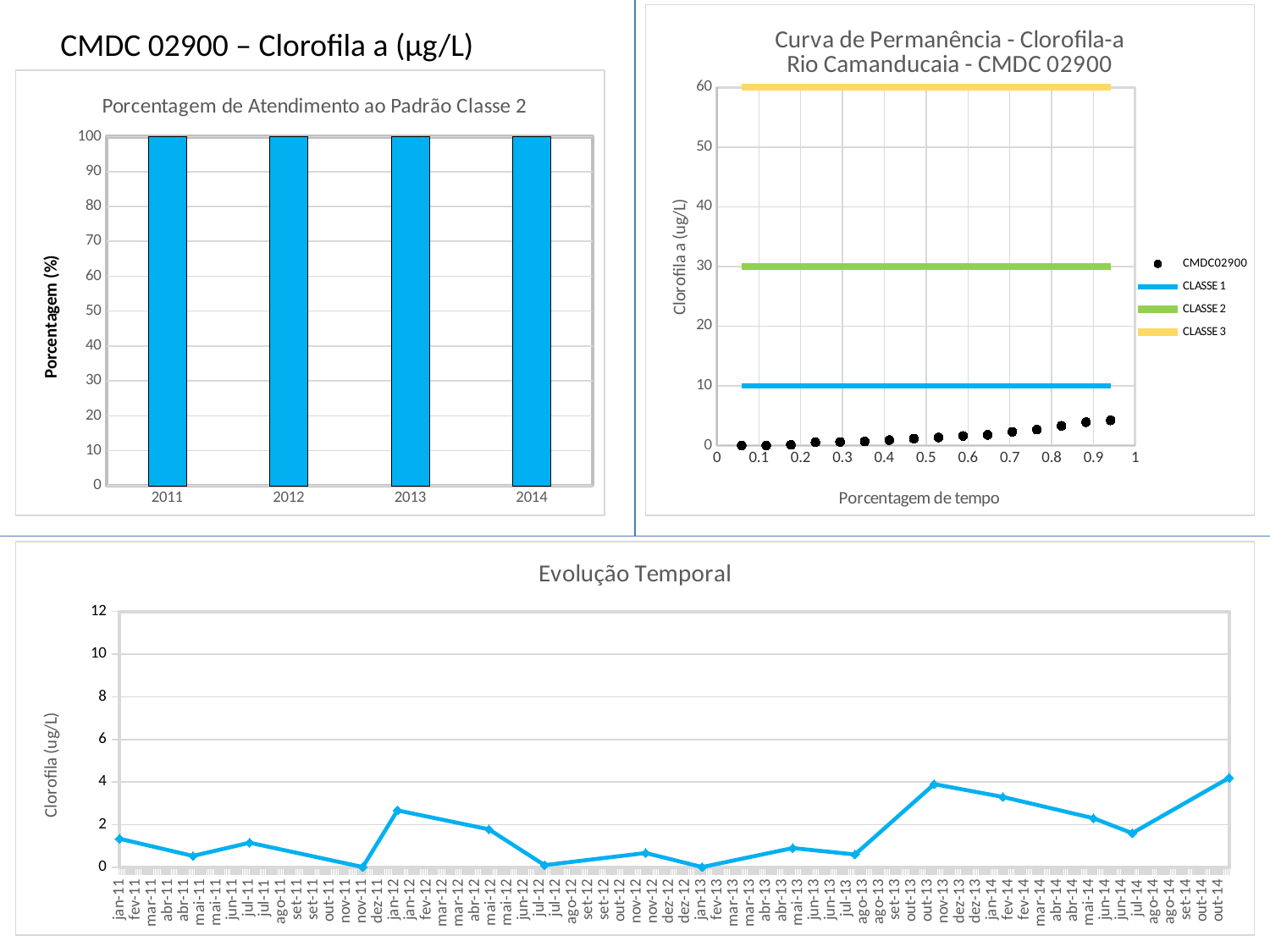
In the 'Evolução Temporal' chart, is the value for nov-11 greater or less than 2? less In the 'Evolução Temporal' chart, is the value for out-13 greater or less than 2? greater In the 'Curva de Permanência' chart, do the CMDC02900 points rise or fall as Porcentagem de tempo increases? rise In the 'Curva de Permanência' chart, at what Clorofila a value is the CLASSE 3 line drawn? 60 In the 'Porcentagem de Atendimento ao Padrão Classe 2' chart, what is the difference between the values for 2011 and 2014? 0 In the 'Porcentagem de Atendimento ao Padrão Classe 2' chart, what kind of chart is shown? bar chart In the 'Porcentagem de Atendimento ao Padrão Classe 2' chart, how many years are shown on the x axis? 4 In the 'Curva de Permanência' chart, at what Clorofila a value is the CLASSE 2 line drawn? 30 In the 'Curva de Permanência' chart, which class line is the lowest? CLASSE 1 In the 'Porcentagem de Atendimento ao Padrão Classe 2' chart, what is the label of the y axis? Porcentagem (%) In the 'Curva de Permanência' chart, how many entries does the legend list? 4 In the 'Porcentagem de Atendimento ao Padrão Classe 2' chart, what is the value for 2013? 100